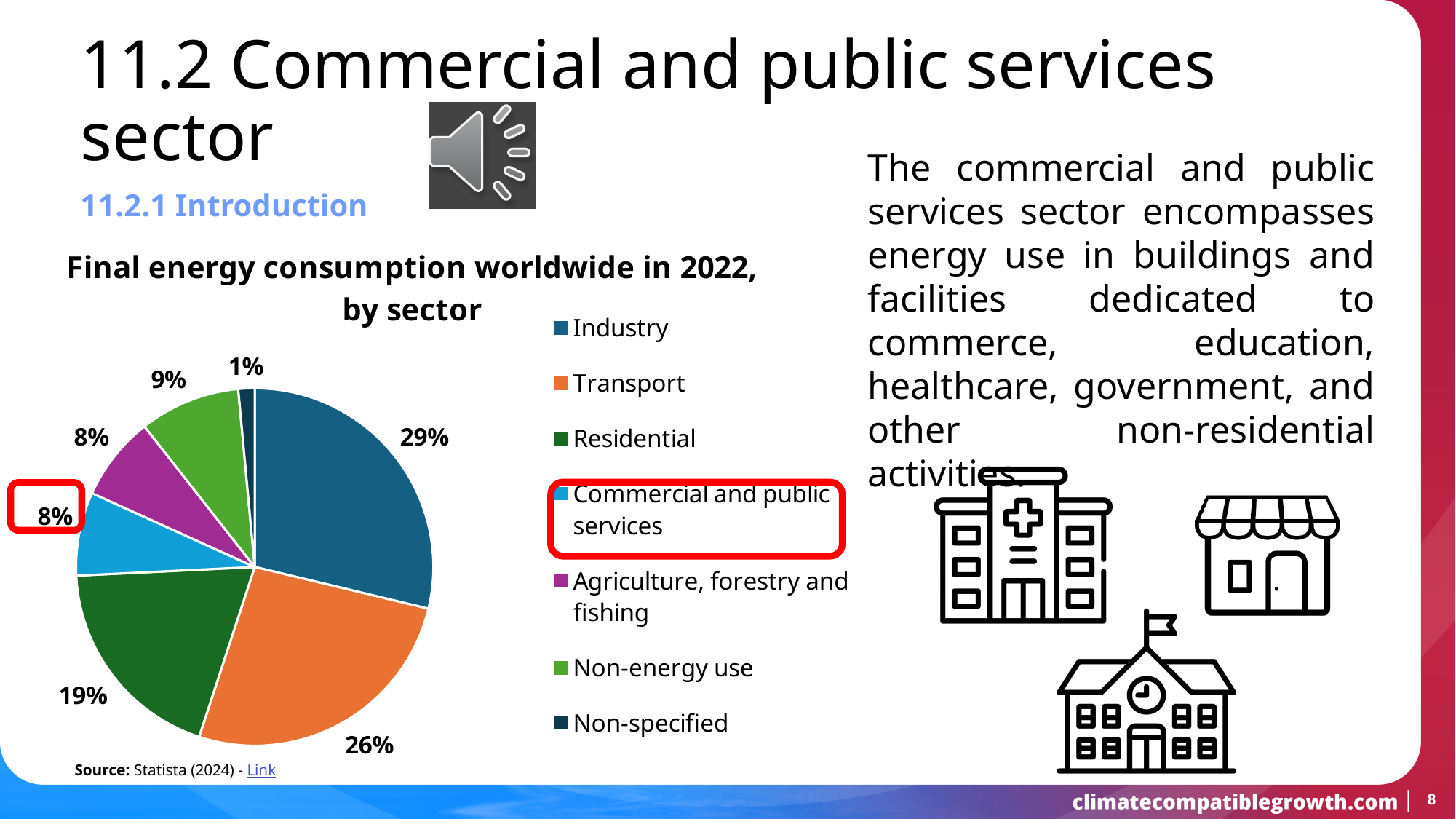
What share of final energy consumption worldwide in 2022 is attributed to Commercial and public services? 8% What is the title of the pie chart? Final energy consumption worldwide in 2022, by sector What share of final energy consumption worldwide in 2022 is attributed to Transport? 26% What share of final energy consumption worldwide in 2022 is attributed to Residential? 19% What type of chart is shown on the slide? pie chart How many sectors are shown in the pie chart? 7 What is the difference in percentage points between the Industry and Transport shares? 3 What share of final energy consumption worldwide in 2022 is attributed to Non-energy use? 9% Which sector has the largest share of final energy consumption worldwide in 2022? Industry Which has a larger share of final energy consumption: Residential or Non-energy use? Residential Which sector has the smallest share of final energy consumption worldwide in 2022? Non-specified What share of final energy consumption worldwide in 2022 is attributed to Industry? 29%